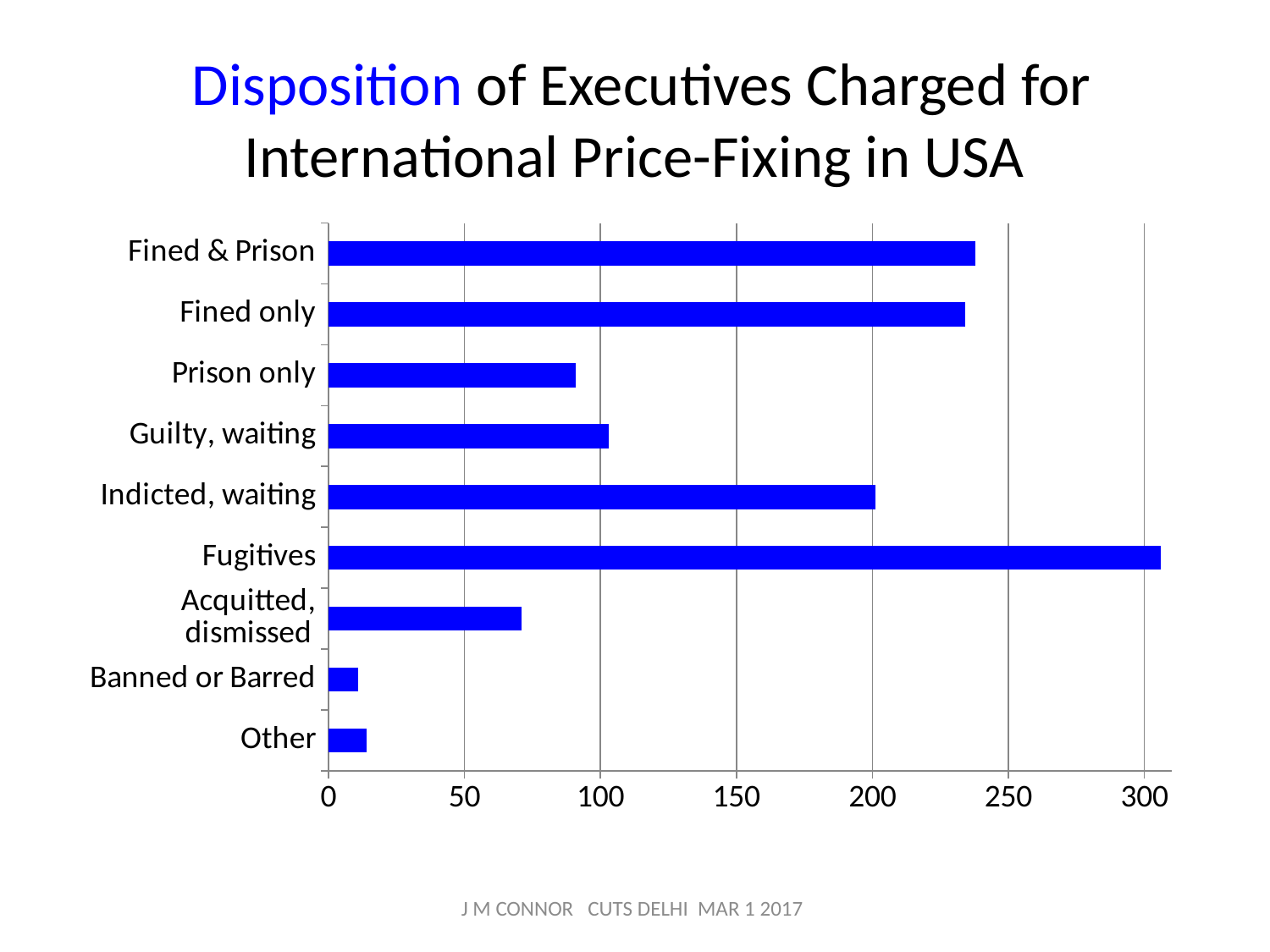
What colour are the bars in the chart? blue Is the value for Acquitted, dismissed greater or less than 50? greater Is the value for Indicted, waiting greater or less than 250? less Which is larger, the value for Prison only or the value for Guilty, waiting? Guilty, waiting What kind of chart is shown on the slide? bar chart Is the value for Fugitives greater or less than 300? greater How many categories are plotted in the chart? 9 Which is larger, the value for Indicted, waiting or the value for Fined only? Fined only Which category has the highest value? Fugitives